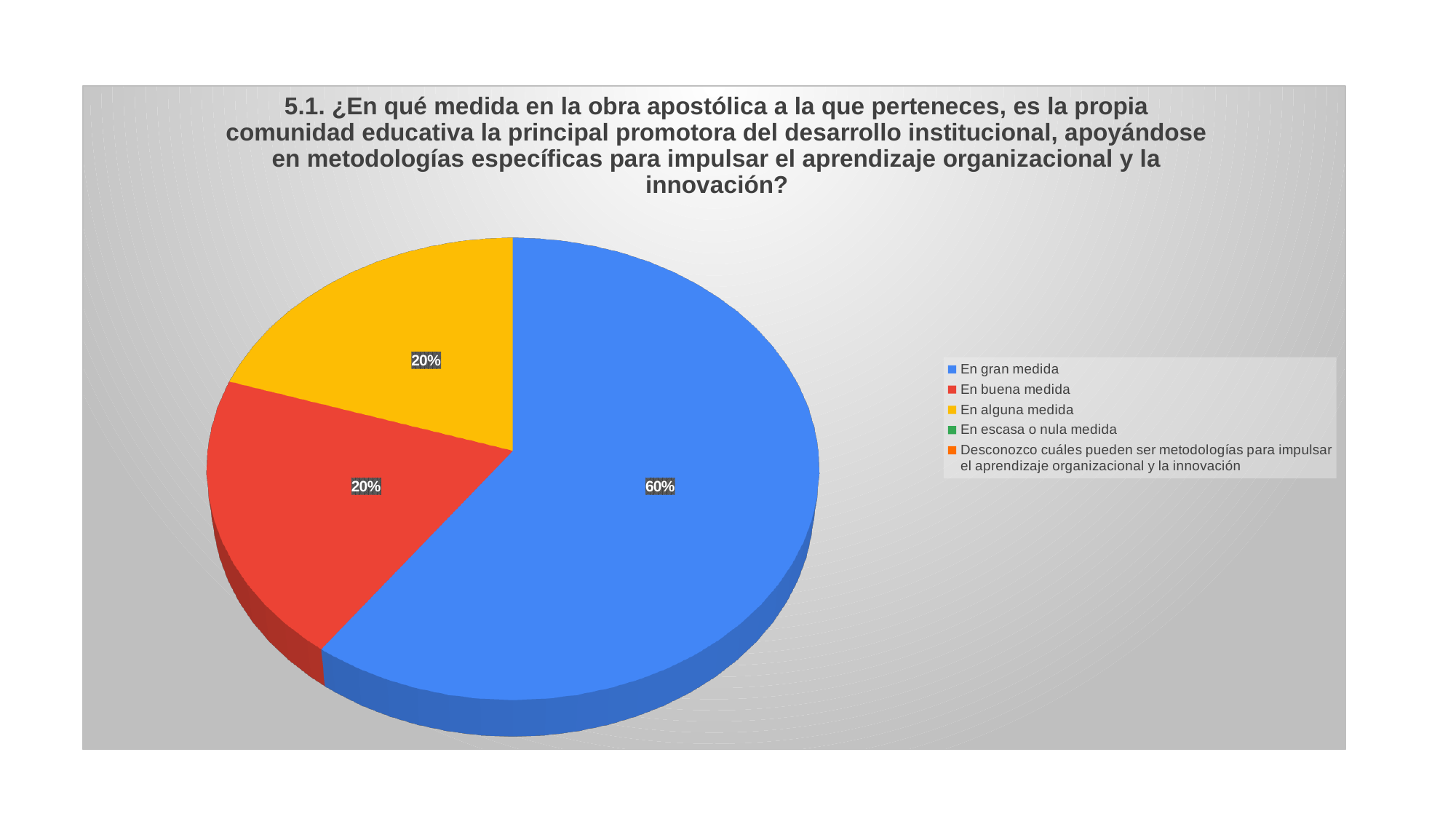
What is the combined share of "En buena medida" and "En alguna medida"? 40% What share of the pie does "En gran medida" represent? 60% What is the difference in percentage points between "En gran medida" and "En buena medida"? 40 Which is larger, the slice for "En gran medida" or the slice for "En alguna medida"? En gran medida What share of the pie does "En alguna medida" represent? 20% Which legend entry is shown in blue? En gran medida What colour is the slice for "En alguna medida"? yellow What kind of chart is shown on the slide? pie chart Which category has the largest slice of the pie? En gran medida What share of the pie does "En buena medida" represent? 20% How many slices with a visible data label are shown in the pie? 3 How many entries does the legend list? 5